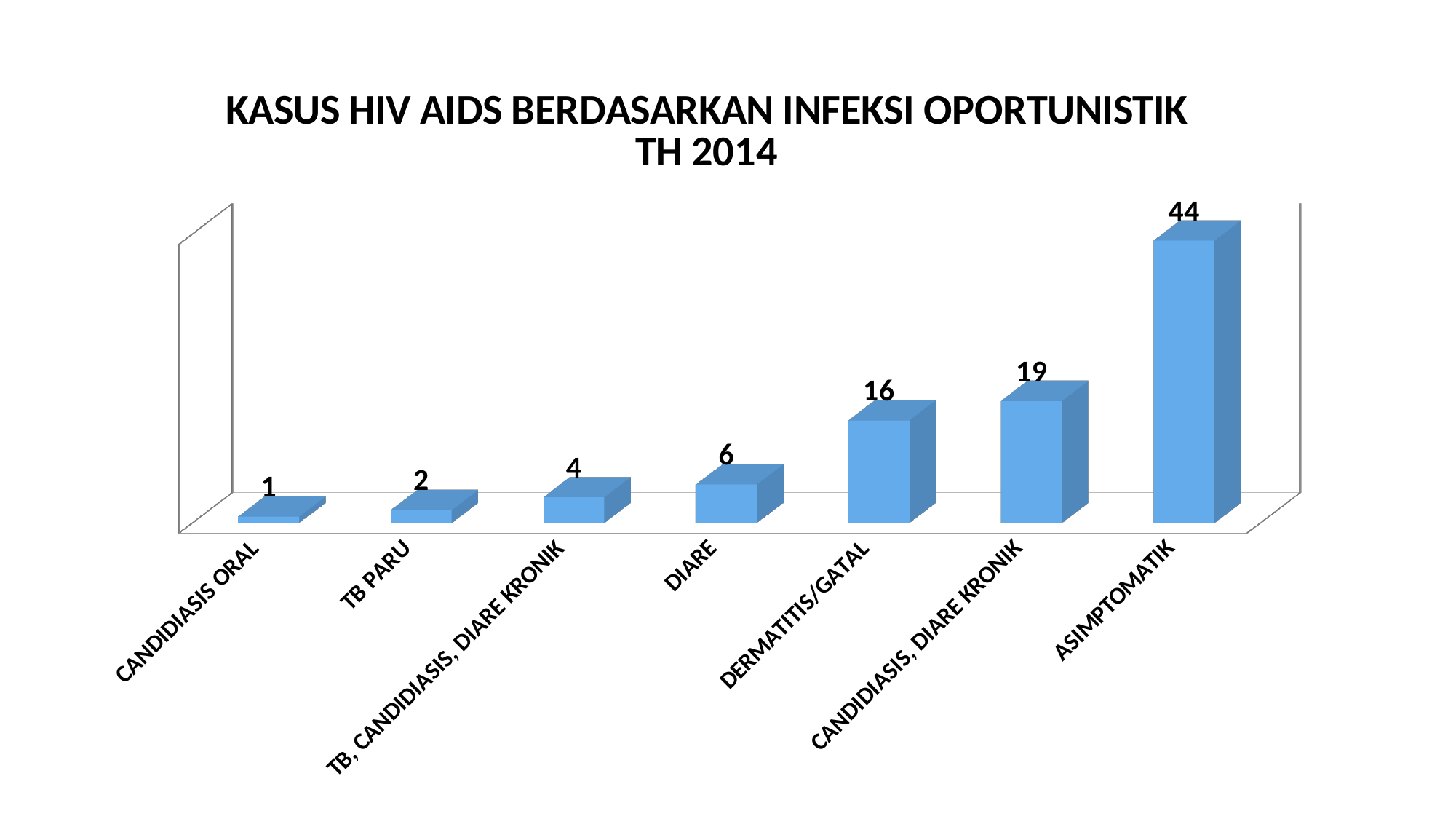
Do the values rise or fall from left to right along the x axis? rise Which category has the highest value? ASIMPTOMATIK What is the value for CANDIDIASIS, DIARE KRONIK? 19 Which category has the lowest value? CANDIDIASIS ORAL What is the difference between the values for ASIMPTOMATIK and CANDIDIASIS, DIARE KRONIK? 25 What is the value for ASIMPTOMATIK? 44 What kind of chart is shown on the slide? bar chart What is the value for TB PARU? 2 What is the value for DERMATITIS/GATAL? 16 How many categories are shown on the x axis? 7 What is the difference between the values for DIARE and TB, CANDIDIASIS, DIARE KRONIK? 2 Which is larger, the value for DERMATITIS/GATAL or the value for DIARE? DERMATITIS/GATAL